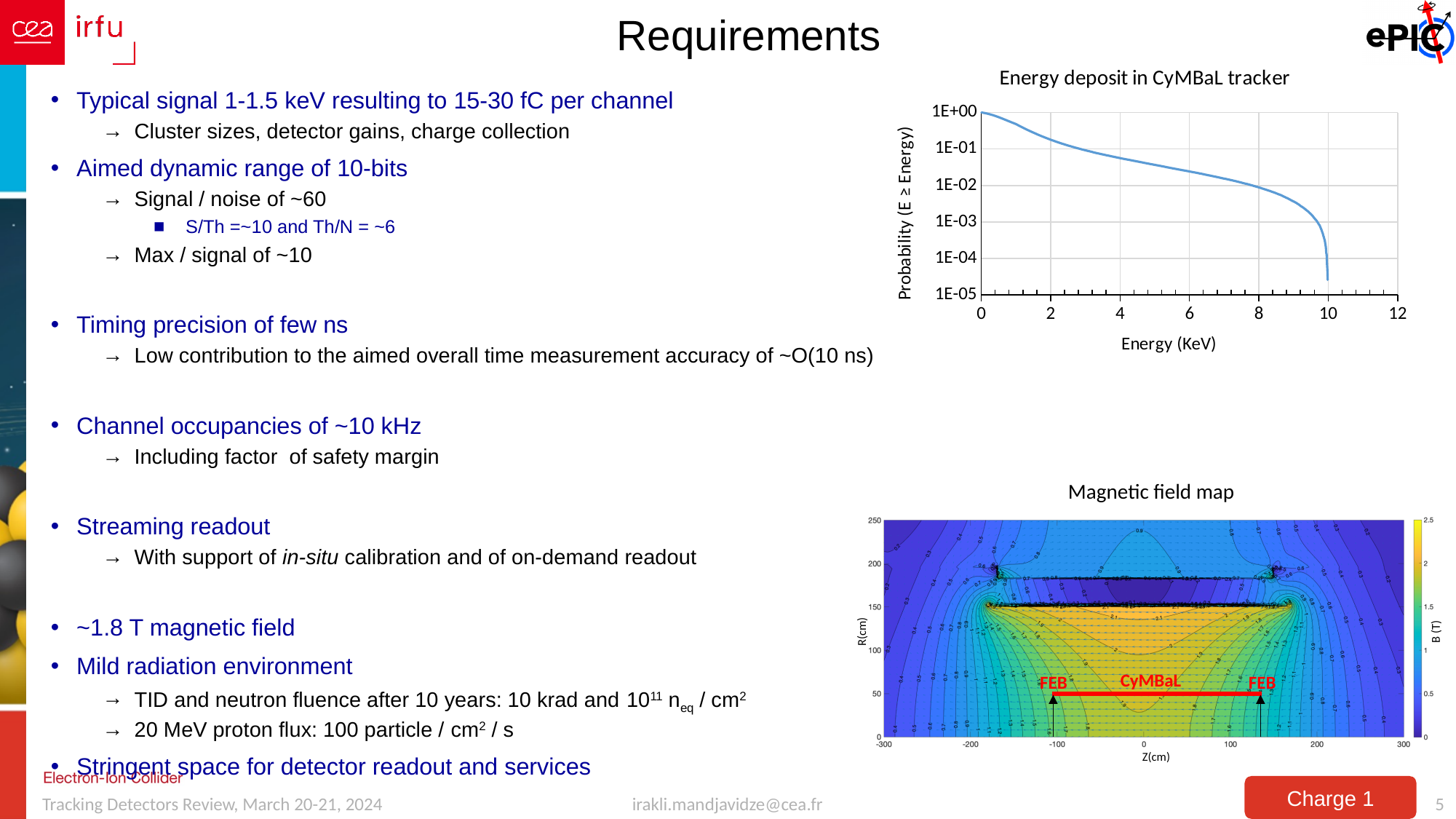
In the 'Energy deposit in CyMBaL tracker' chart, is the probability at 4 KeV greater or less than 1E-01? less In the 'Energy deposit in CyMBaL tracker' chart, does the probability rise or fall as energy increases? fall In the 'Energy deposit in CyMBaL tracker' chart, is the probability at 2 KeV larger or smaller than the probability at 8 KeV? larger What is the title of the chart in the upper right of the slide? Energy deposit in CyMBaL tracker In the 'Energy deposit in CyMBaL tracker' chart, is the probability at 6 KeV greater or less than 1E-02? greater In the 'Energy deposit in CyMBaL tracker' chart, at which energy value is the probability highest? 0 In the 'Energy deposit in CyMBaL tracker' chart, what kind of chart is shown? line chart In the 'Magnetic field map' chart, what is the label of the colour bar on the right? B (T) In the 'Energy deposit in CyMBaL tracker' chart, what is the label of the x axis? Energy (KeV) In the 'Energy deposit in CyMBaL tracker' chart, is the probability at 2 KeV greater or less than 1E-01? greater In the 'Energy deposit in CyMBaL tracker' chart, how many lines (series) are plotted? 1